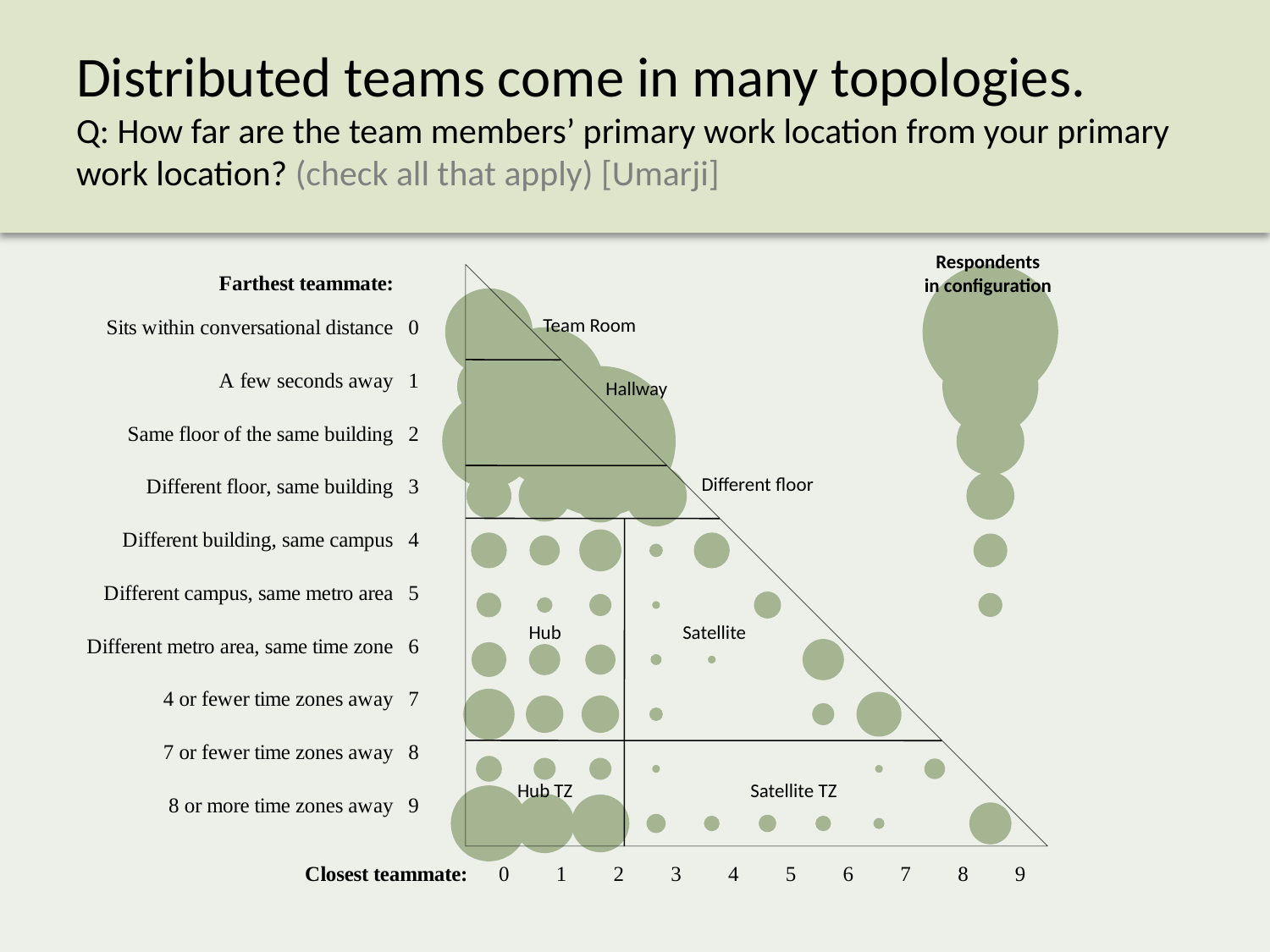
In the 'Respondents in configuration' column, which 'Farthest teammate' row has the largest bubble? Sits within conversational distance (0) How many categories are listed on the 'Farthest teammate' axis? 10 How many values are shown along the 'Closest teammate' axis? 10 What number is assigned to the 'Farthest teammate' category 'A few seconds away'? 1 What is the label of the region in the top-left corner of the triangle? Team Room Which 'Farthest teammate' category is numbered 4? Different building, same campus What is the heading of the column of bubbles on the right side of the chart? Respondents in configuration What kind of chart is shown on the slide? bubble chart Which 'Farthest teammate' category is numbered 9? 8 or more time zones away